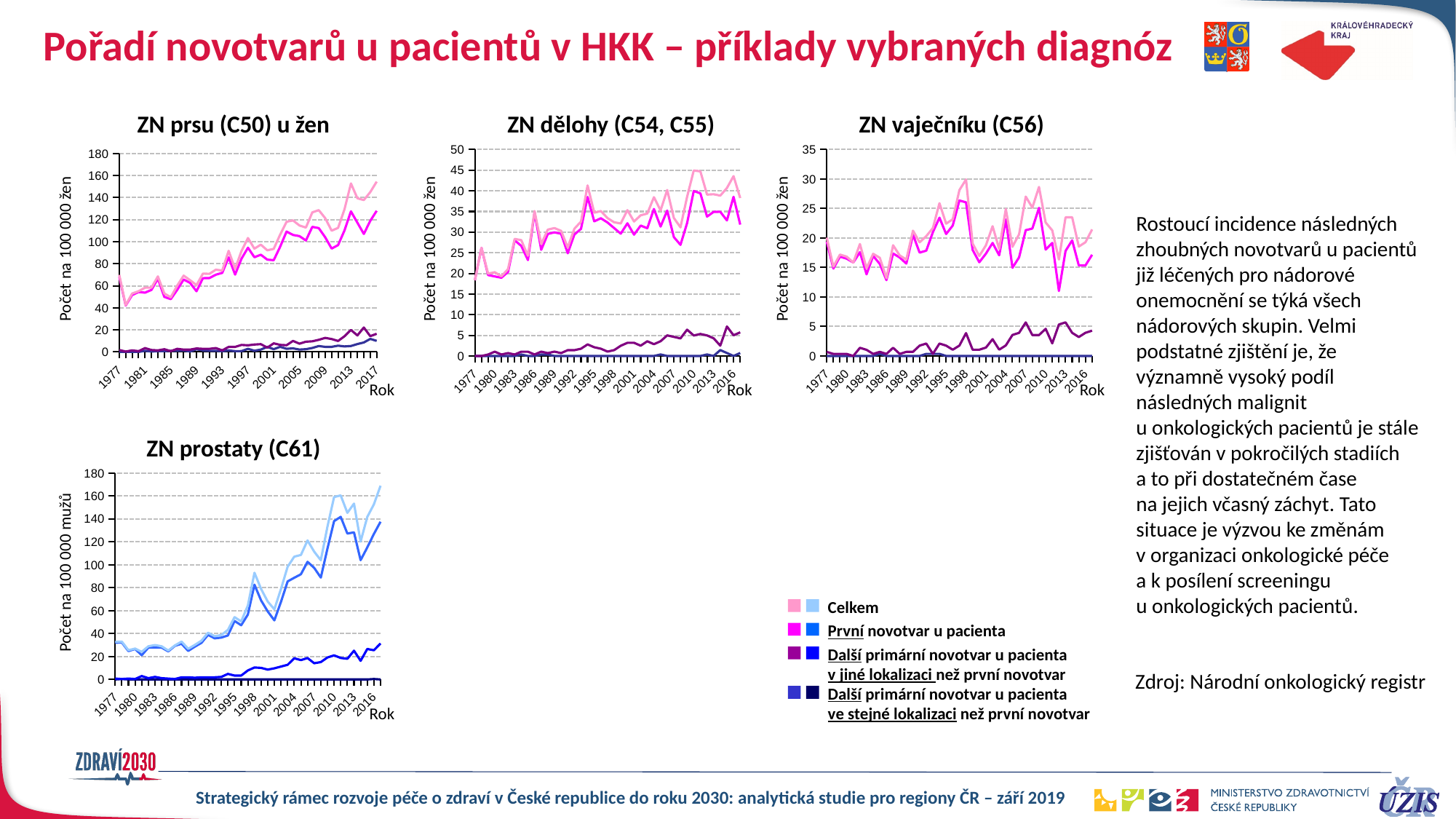
How many series does the legend list? 4 In the "ZN prostaty (C61)" chart, is the Celkem value in 2016 greater or less than 140? greater In the "ZN prsu (C50) u žen" chart, is the Celkem value in 2017 greater or less than 140? greater In the "ZN vaječníku (C56)" chart, is the highest Celkem value greater or less than 25? greater In the "ZN prostaty (C61)" chart, does the "Další primární novotvar u pacienta v jiné lokalizaci než první novotvar" line rise or fall over time? rise In the "ZN prsu (C50) u žen" chart, which is higher in 2017: Celkem or První novotvar u pacienta? Celkem In the "ZN prsu (C50) u žen" chart, does the Celkem line rise or fall from 1977 to 2017? rise What kind of chart is "ZN prsu (C50) u žen"? line chart How many charts are shown on the slide? 4 What is the y-axis label of the "ZN prostaty (C61)" chart? Počet na 100 000 mužů